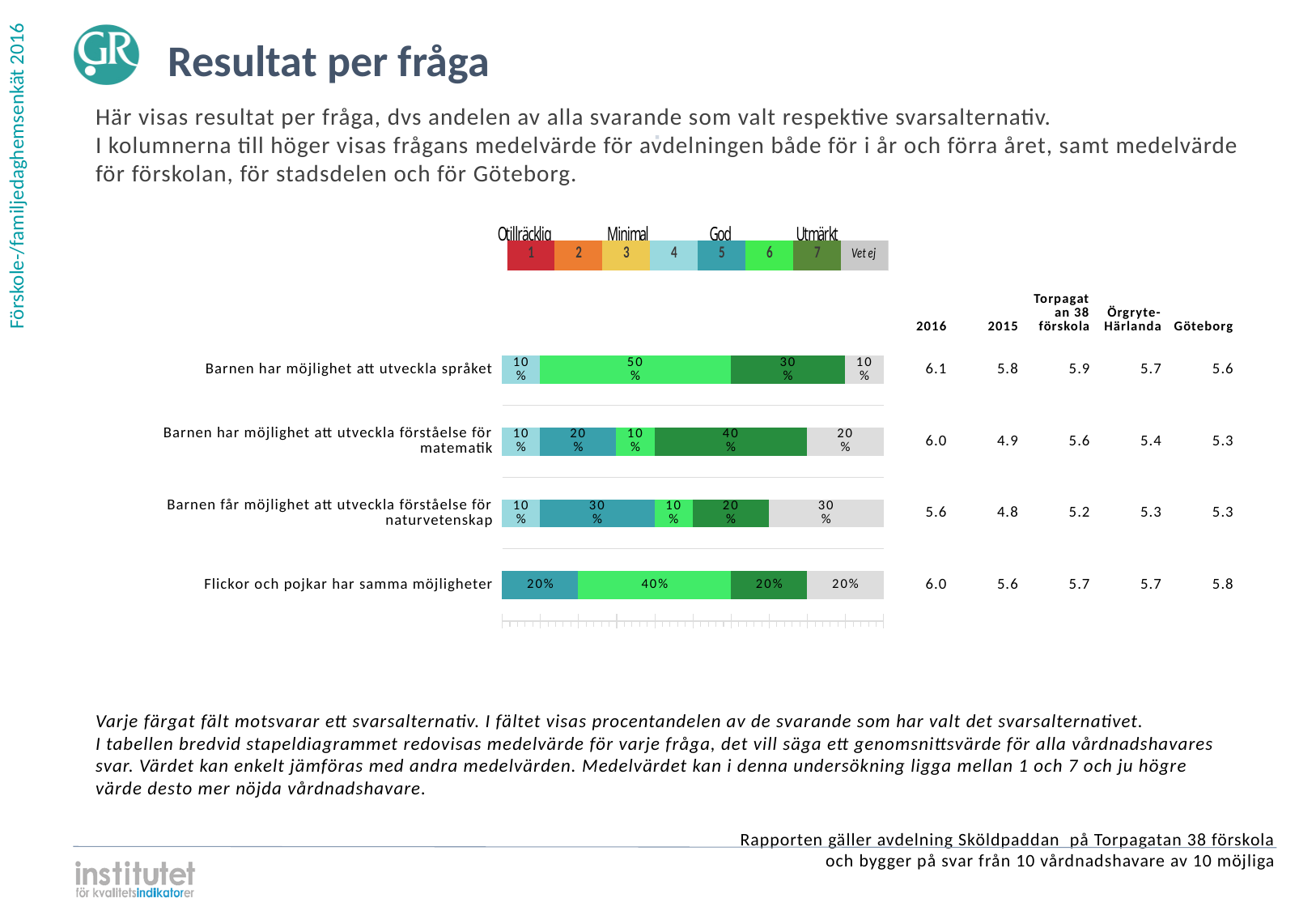
What is the 'Vet ej' share for 'Barnen får möjlighet att utveckla förståelse för naturvetenskap'? 30% What percentage of respondents chose answer 6 (bright green) for 'Barnen har möjlighet att utveckla språket'? 50% What type of chart is shown on the slide? Stacked bar chart What percentage of respondents chose answer 7 (dark green) for 'Barnen har möjlighet att utveckla förståelse för matematik'? 40% What is the total of all segments in the bar for 'Flickor och pojkar har samma möjligheter'? 100% How many entries does the legend above the chart list? 8 What is the difference between the answer 7 share and the answer 6 share for 'Barnen har möjlighet att utveckla förståelse för matematik'? 30% What is the 2016 mean value shown for 'Barnen har möjlighet att utveckla språket'? 6.1 Which is larger for 'Barnen får möjlighet att utveckla förståelse för naturvetenskap': the share for answer 5 or the share for answer 7? Answer 5 Which answer alternative has the largest share for 'Barnen har möjlighet att utveckla språket'? 6 How many questions (categories) are plotted in the bar chart? 4 What percentage chose answer 6 (bright green) for 'Flickor och pojkar har samma möjligheter'? 40%